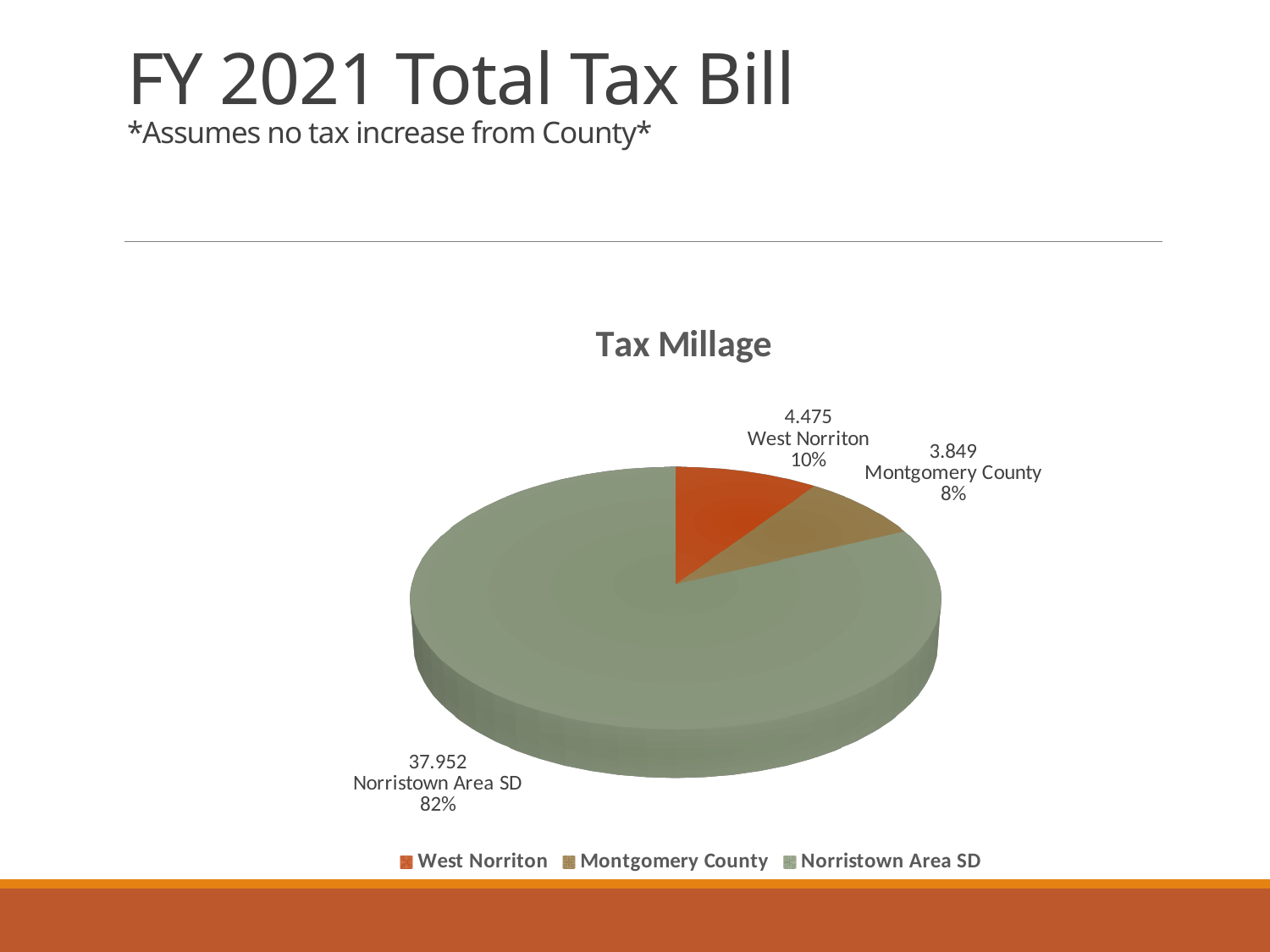
How many categories are shown in the pie chart? 3 Which category has the largest slice of the pie? Norristown Area SD Which category has the smallest slice of the pie? Montgomery County What is the difference between the West Norriton and Montgomery County millage values? 0.626 What share of the pie does Montgomery County represent? 8% What share of the pie does Norristown Area SD represent? 82% Which is larger, the millage for West Norriton or for Montgomery County? West Norriton What is the tax millage value for Norristown Area SD? 37.952 What type of chart is shown on the slide? Pie chart What is the tax millage value for West Norriton? 4.475 What is the tax millage value for Montgomery County? 3.849 What share of the pie does West Norriton represent? 10%